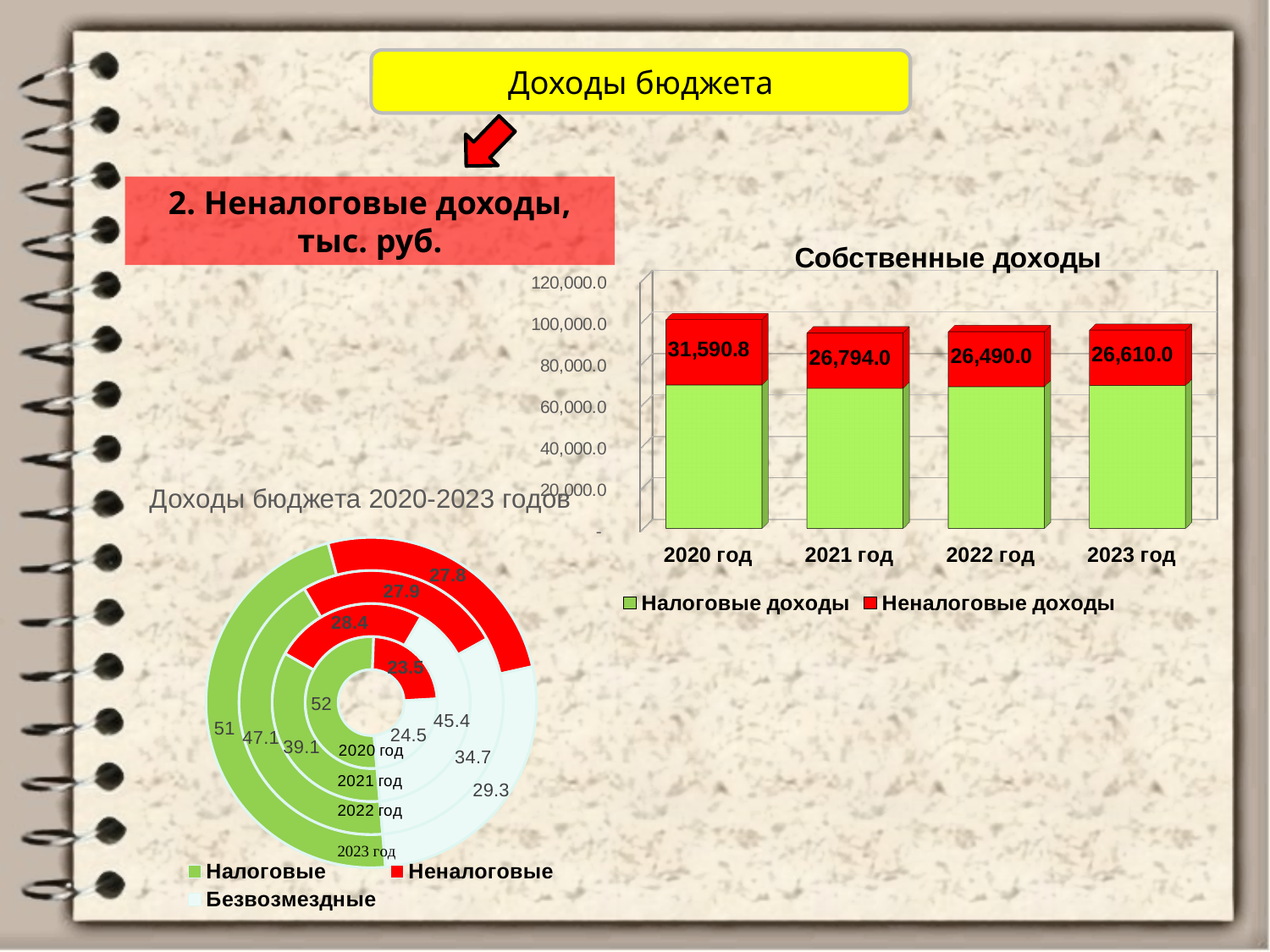
In the 'Собственные доходы' chart, is the total height of the 2020 год bar greater or less than 80,000.0? greater In the 'Собственные доходы' chart, what is the value of Неналоговые доходы for 2022 год? 26,490.0 What kind of chart is 'Собственные доходы'? Stacked bar chart In the 'Собственные доходы' chart, what is the value of Неналоговые доходы for 2023 год? 26,610.0 In the 'Собственные доходы' chart, what is the value of Неналоговые доходы for 2020 год? 31,590.8 In the 'Собственные доходы' chart, which year has the lowest Неналоговые доходы? 2022 год In the 'Собственные доходы' chart, what is the value of Неналоговые доходы for 2021 год? 26,794.0 How many series does the legend of the 'Доходы бюджета 2020-2023 годов' chart list? 3 How many years are shown on the x axis of the 'Собственные доходы' chart? 4 In the 'Собственные доходы' chart, what is the difference between Неналоговые доходы in 2020 год and 2021 год? 4,796.8 In the 'Собственные доходы' chart, is Неналоговые доходы larger in 2023 год or in 2022 год? 2023 год In the 'Собственные доходы' chart, which year has the highest Неналоговые доходы? 2020 год